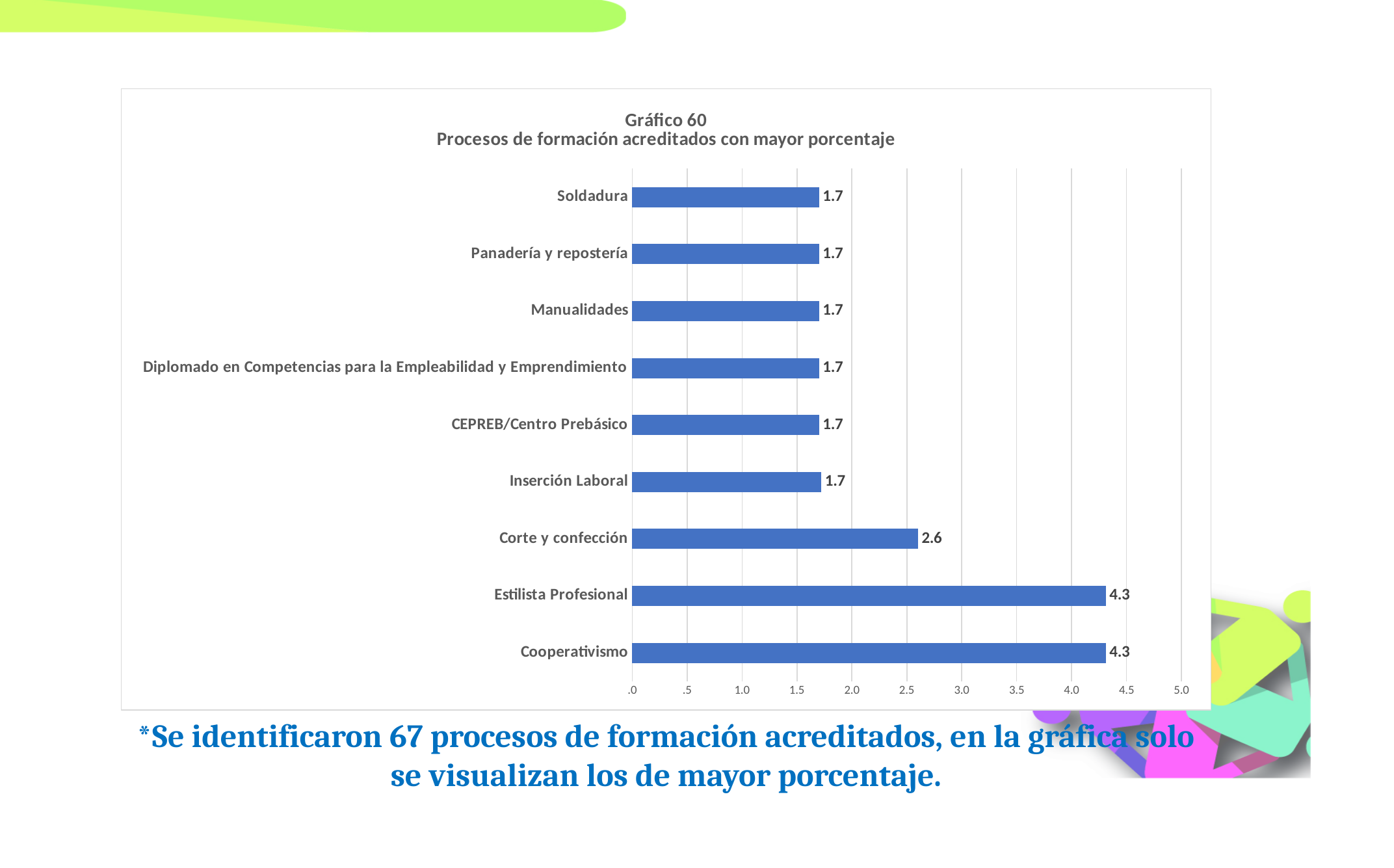
What is the value for Estilista Profesional? 4.3 What is the value for Inserción Laboral? 1.7 How many categories are shown in the chart? 9 What kind of chart is shown on the slide? bar chart Which is larger, the value for Cooperativismo or the value for Corte y confección? Cooperativismo What is the value for Corte y confección? 2.6 What is the highest value shown on the x axis? 5.0 What is the difference between the values for Estilista Profesional and Corte y confección? 1.7 What is the value for Soldadura? 1.7 What is the difference between the values for Corte y confección and Manualidades? 0.9 What is the title of the chart? Gráfico 60 Procesos de formación acreditados con mayor porcentaje Is the value for Corte y confección greater or less than 2.0? greater